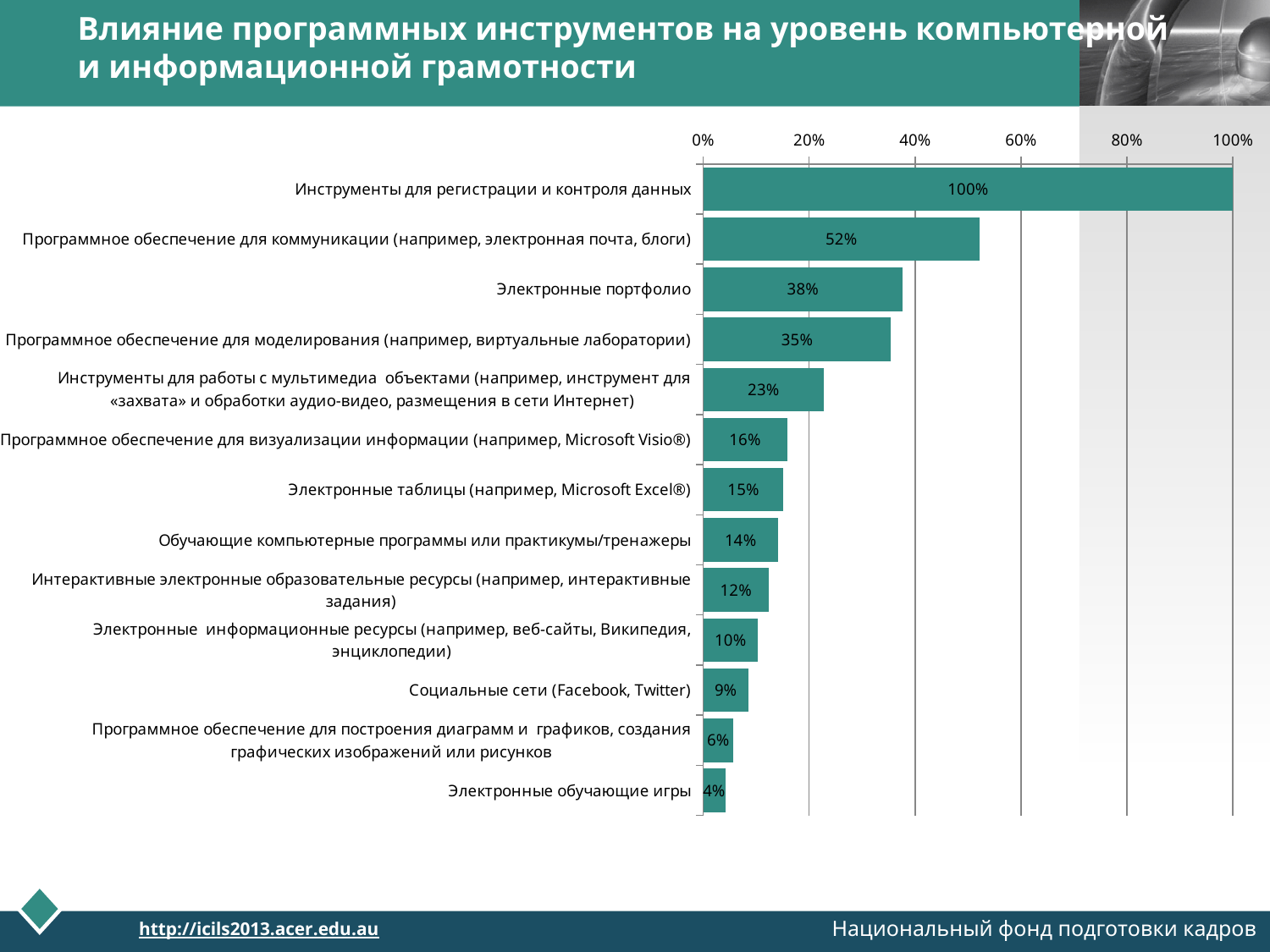
What is the value for Программное обеспечение для моделирования (например, виртуальные лаборатории)? 35% What kind of chart is shown on the slide? bar chart What is the difference between the values for Программное обеспечение для коммуникации (например, электронная почта, блоги) and Электронные портфолио? 14% What is the value for Электронные портфолио? 38% Which category has the highest value? Инструменты для регистрации и контроля данных Is the value for Программное обеспечение для коммуникации (например, электронная почта, блоги) greater or less than 40%? greater What is the value for Электронные таблицы (например, Microsoft Excel®)? 15% What is the difference between the values for Инструменты для работы с мультимедиа объектами and Электронные обучающие игры? 19% Which category has the lowest value? Электронные обучающие игры What is the value for Социальные сети (Facebook, Twitter)? 9% Which is larger: the value for Обучающие компьютерные программы или практикумы/тренажеры or the value for Электронные информационные ресурсы (например, веб-сайты, Википедия, энциклопедии)? Обучающие компьютерные программы или практикумы/тренажеры How many categories are shown in the chart? 13